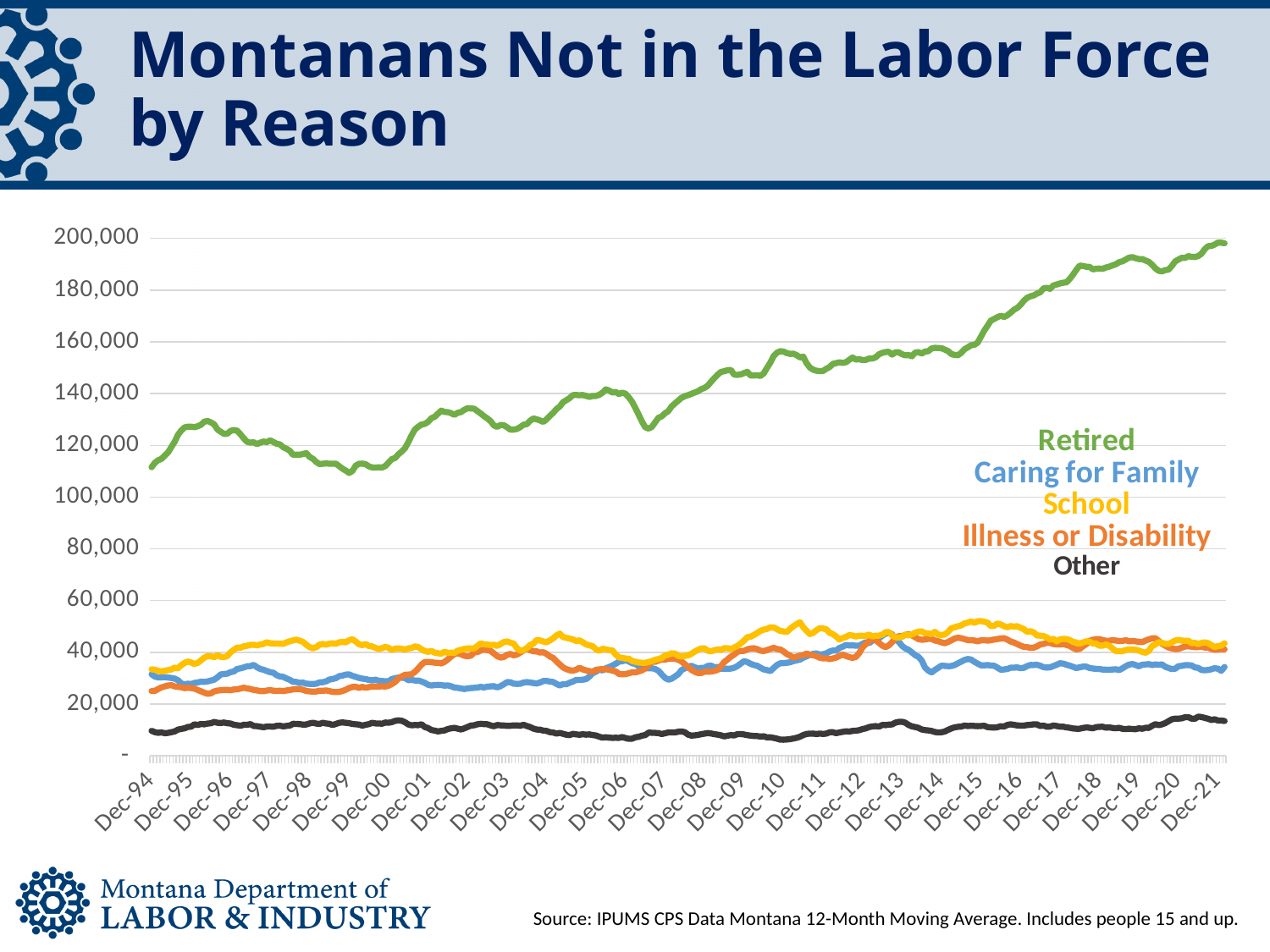
What colour is the Retired line? green Is the value for Other at Dec-21 greater or less than 20,000? less Which series has the lowest values across the whole chart? Other Does the Retired series rise or fall from Dec-94 to Dec-21? rise Is the value for Retired at Dec-21 greater or less than 180,000? greater Which series has the highest values across the whole chart? Retired Is the value for Retired at Dec-94 greater or less than 120,000? less What kind of chart is shown on the slide? line chart At Dec-21, which is larger: Caring for Family or Other? Caring for Family How many series does the chart show? 5 What is the title of the chart on the slide? Montanans Not in the Labor Force by Reason